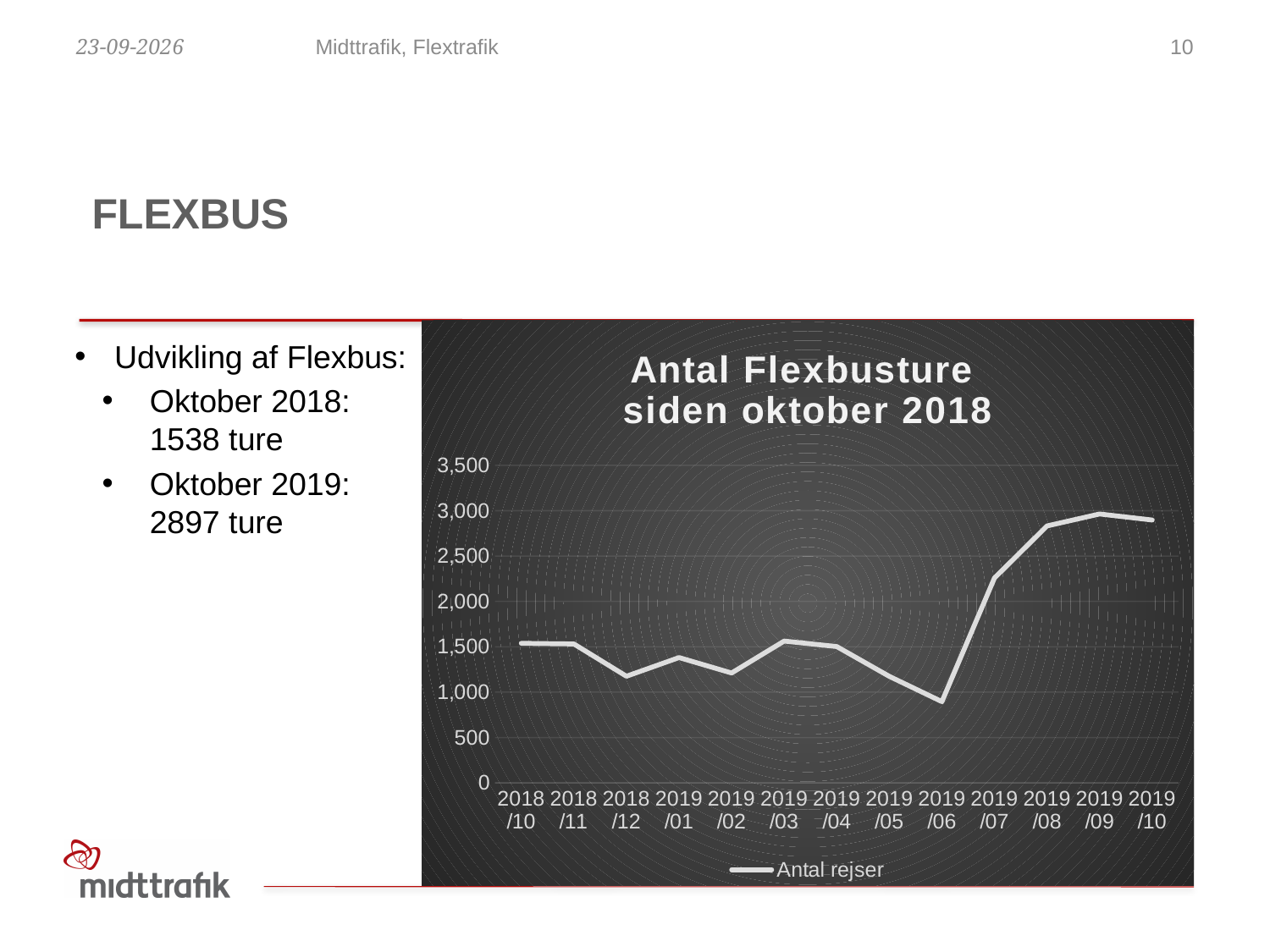
What is the name of the series in the chart legend? Antal rejser Which is larger, the value for 2019/08 or the value for 2018/10? 2019/08 How many months (data points) are plotted on the x axis? 13 Do the values rise or fall from 2019/06 to 2019/09? rise What is the title of the chart? Antal Flexbusture siden oktober 2018 Which month has the lowest number of Flexbus trips? 2019/06 How many series does the chart legend list? 1 Is the value for 2018/12 greater or less than 1,500? less Which month has the highest number of Flexbus trips? 2019/09 Is the value for 2019/06 greater or less than 1,000? less Is the value for 2019/08 greater or less than 2,500? greater What kind of chart is shown on the slide? line chart